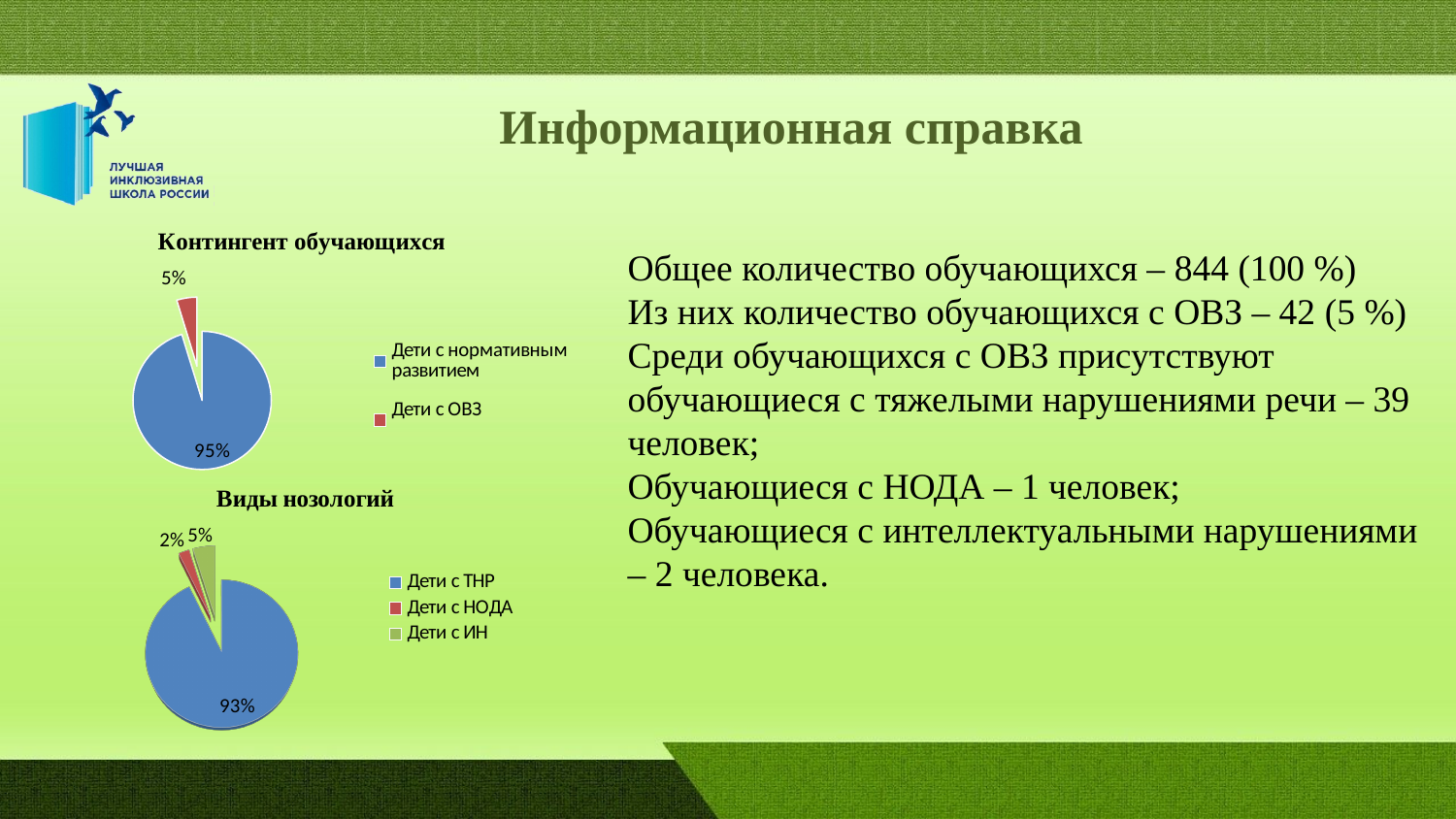
In the chart titled "Контингент обучающихся", which category has the largest slice? Дети с нормативным развитием In the chart titled "Контингент обучающихся", what share of the pie is "Дети с нормативным развитием"? 95% In the chart titled "Контингент обучающихся", what share of the pie is "Дети с ОВЗ"? 5% What kind of chart is the one titled "Виды нозологий"? Pie chart In the chart titled "Виды нозологий", what share of the pie is "Дети с ИН"? 5% In the chart titled "Виды нозологий", what share of the pie is "Дети с ТНР"? 93% In the chart titled "Контингент обучающихся", how many categories does the legend list? 2 In the chart titled "Виды нозологий", what is the difference between the shares of "Дети с ТНР" and "Дети с ИН"? 88% In the chart titled "Виды нозологий", which is larger: "Дети с ИН" or "Дети с НОДА"? Дети с ИН In the chart titled "Виды нозологий", what share of the pie is "Дети с НОДА"? 2% In the chart titled "Виды нозологий", which category has the smallest slice? Дети с НОДА In the chart titled "Виды нозологий", how many slices does the pie have? 3